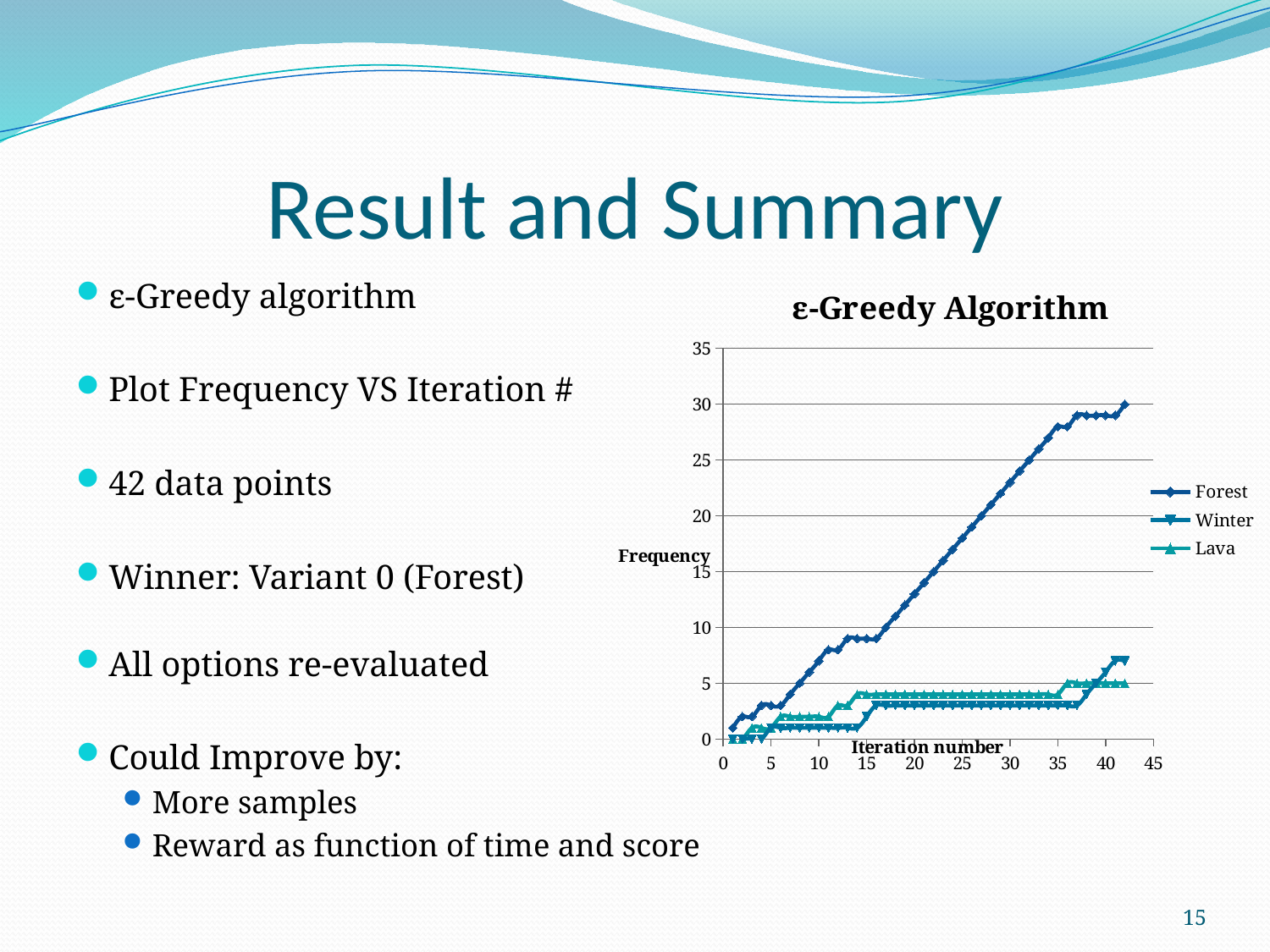
Is the frequency for Lava at iteration 20 greater or less than 5? less Which series has the lowest frequency at the final iteration? Lava What is the label of the x axis of the chart? Iteration number What kind of chart is shown on the slide? line chart Is the frequency for Forest at iteration 42 greater or less than 25? greater Is the frequency for Winter at iteration 30 greater or less than 10? less What is the title of the chart? ε-Greedy Algorithm How many series does the legend of the chart list? 3 At iteration 40, which series has the higher frequency, Forest or Winter? Forest Does the frequency for Forest rise or fall as the iteration number increases? rises Which series reaches the highest frequency in the chart? Forest How many data points are plotted per series, according to the slide? 42